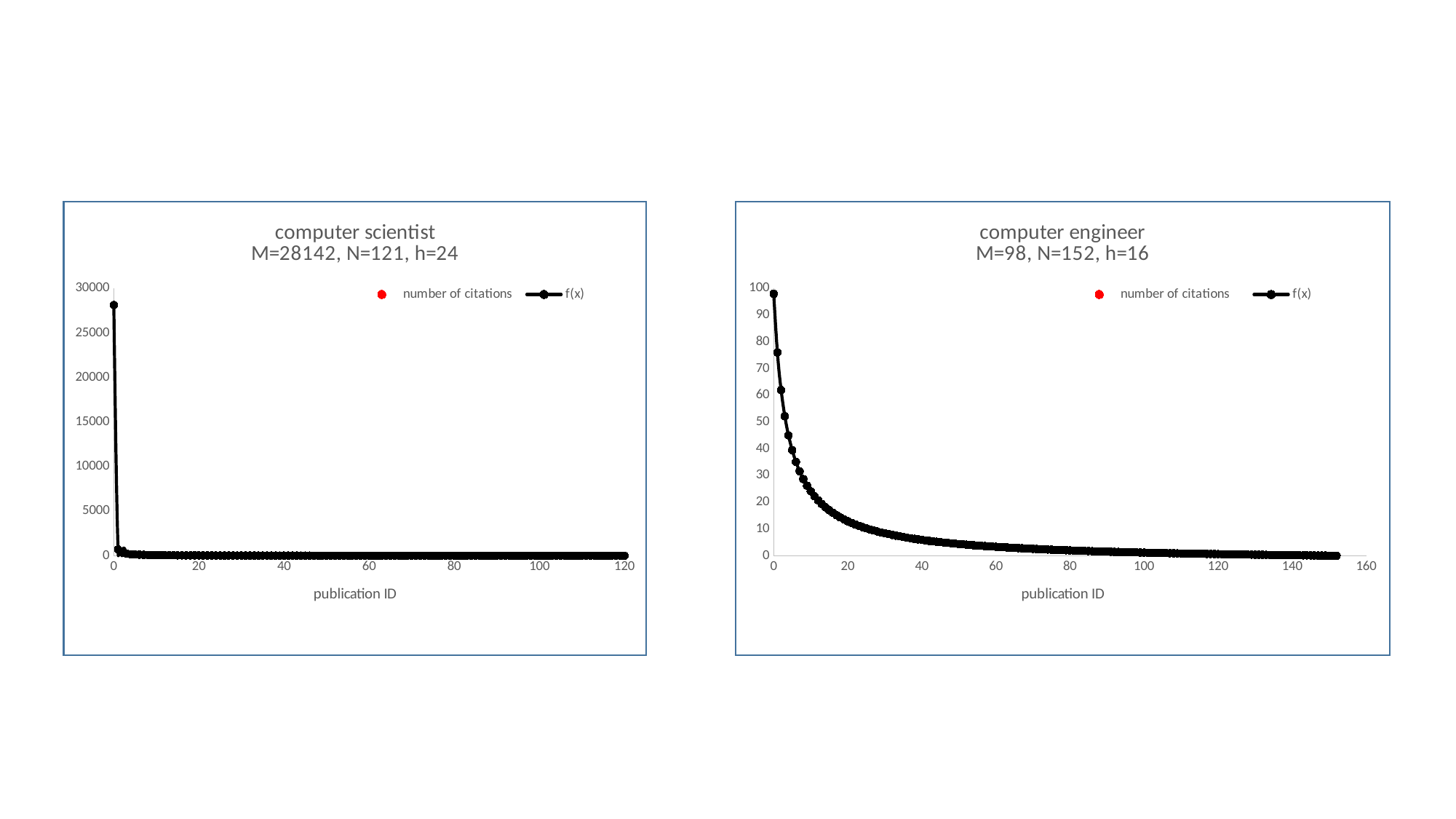
In the 'computer engineer' chart, is the value at publication ID 1 greater or less than 90? greater In the 'computer scientist' chart, do the values rise or fall along the x axis? fall According to its title, how many publications (N) are plotted in the 'computer engineer' chart? 152 In the 'computer engineer' chart, is the value at publication ID 100 greater or less than 10? less What is the x-axis label of the 'computer scientist' chart? publication ID How many series does the legend of the 'computer engineer' chart list? 2 In the 'computer scientist' chart, is the value at publication ID 1 greater or less than 25000? greater In the 'computer engineer' chart, do the values rise or fall as publication ID increases? fall What kind of chart is the 'computer scientist' chart? line chart What are the two legend entries in the 'computer engineer' chart? number of citations, f(x)